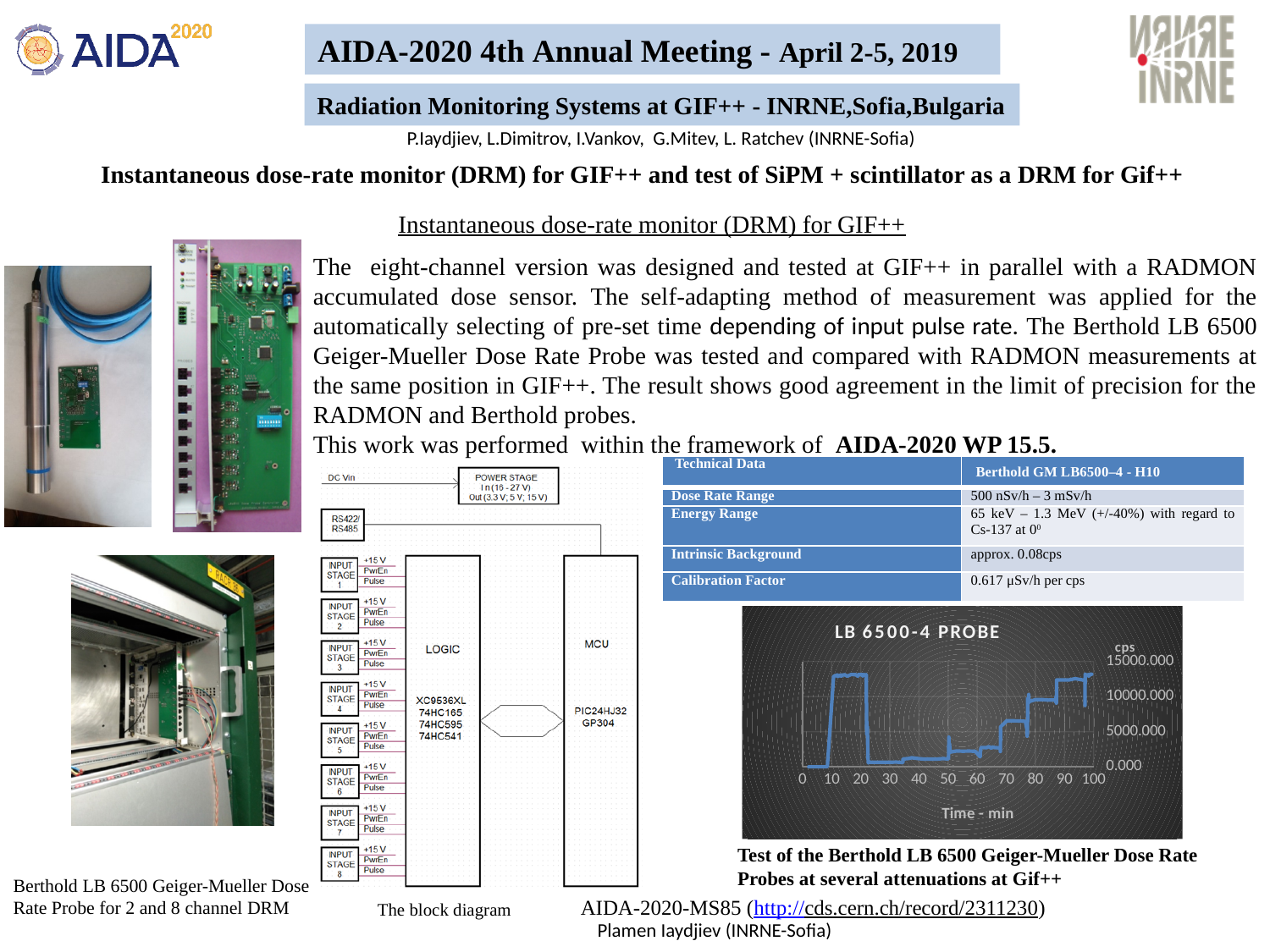
In the "LB 6500-4 PROBE" chart, does the value rise or fall between 60 min and 95 min? rise What is the highest tick value shown on the y axis of the "LB 6500-4 PROBE" chart? 15000.000 In the "LB 6500-4 PROBE" chart, which is larger, the value at 75 min or the value at 85 min? 85 min In the "LB 6500-4 PROBE" chart, is the value at 85 min greater or less than 5000? greater In the "LB 6500-4 PROBE" chart, is the value at 65 min greater or less than 10000? less In the "LB 6500-4 PROBE" chart, which is larger, the value at 15 min or the value at 40 min? 15 min What is the x-axis label of the "LB 6500-4 PROBE" chart? Time - min What kind of chart is the "LB 6500-4 PROBE" chart? line chart In the "LB 6500-4 PROBE" chart, is the value at 15 min greater or less than 10000? greater What is the title of the chart on the slide? LB 6500-4 PROBE